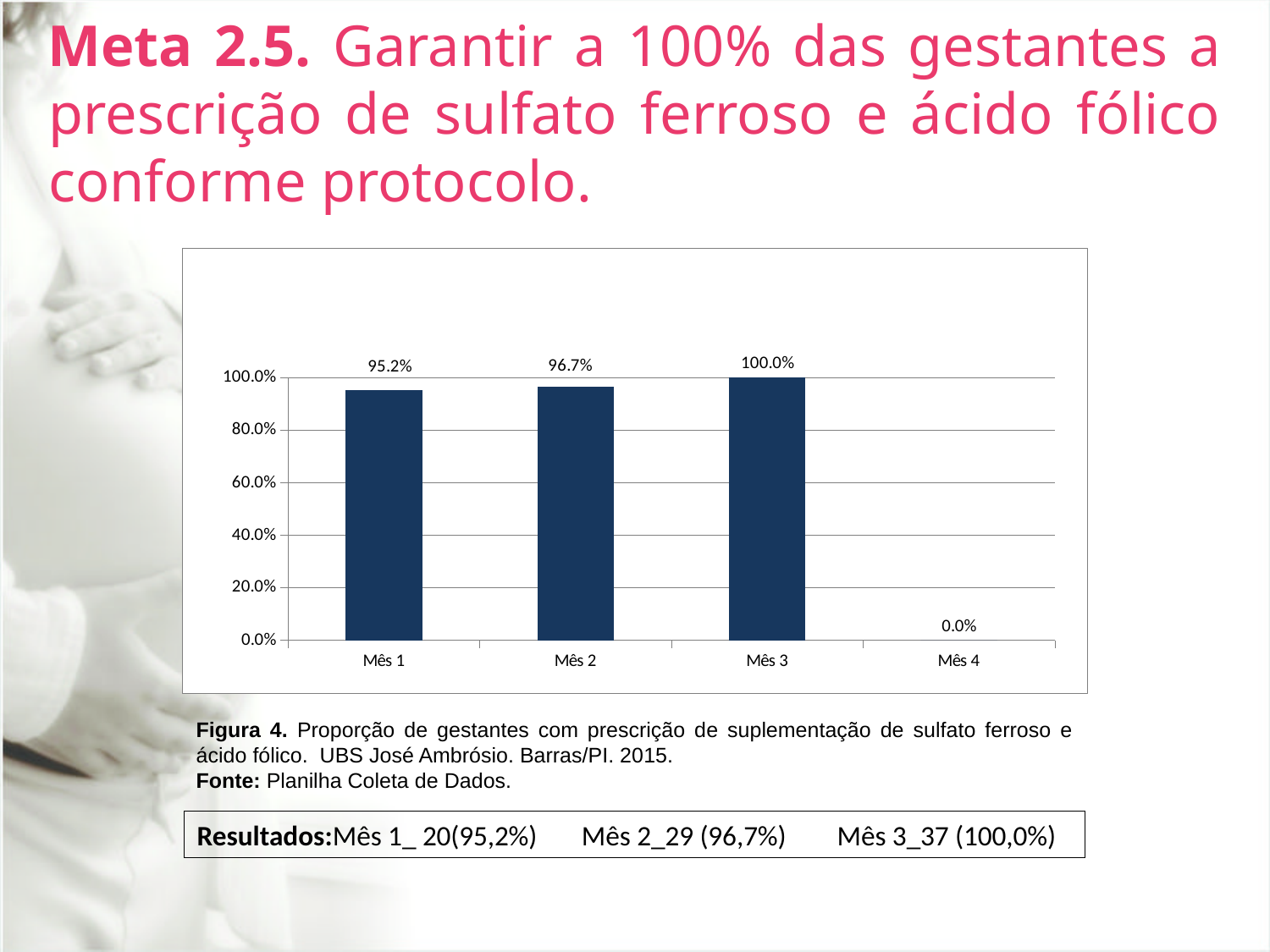
What is the difference between the values for Mês 3 and Mês 1? 4.8% What is the value for Mês 1? 95.2% What is the value for Mês 4? 0.0% What is the value for Mês 2? 96.7% Do the values rise or fall from Mês 1 to Mês 3? rise Which month has the lowest value? Mês 4 Which month has the highest value? Mês 3 What kind of chart is shown on the slide? bar chart Is the value for Mês 2 greater or less than 80.0%? greater What is the value for Mês 3? 100.0% Which is larger, the value for Mês 2 or the value for Mês 1? Mês 2 How many months are shown on the x axis? 4